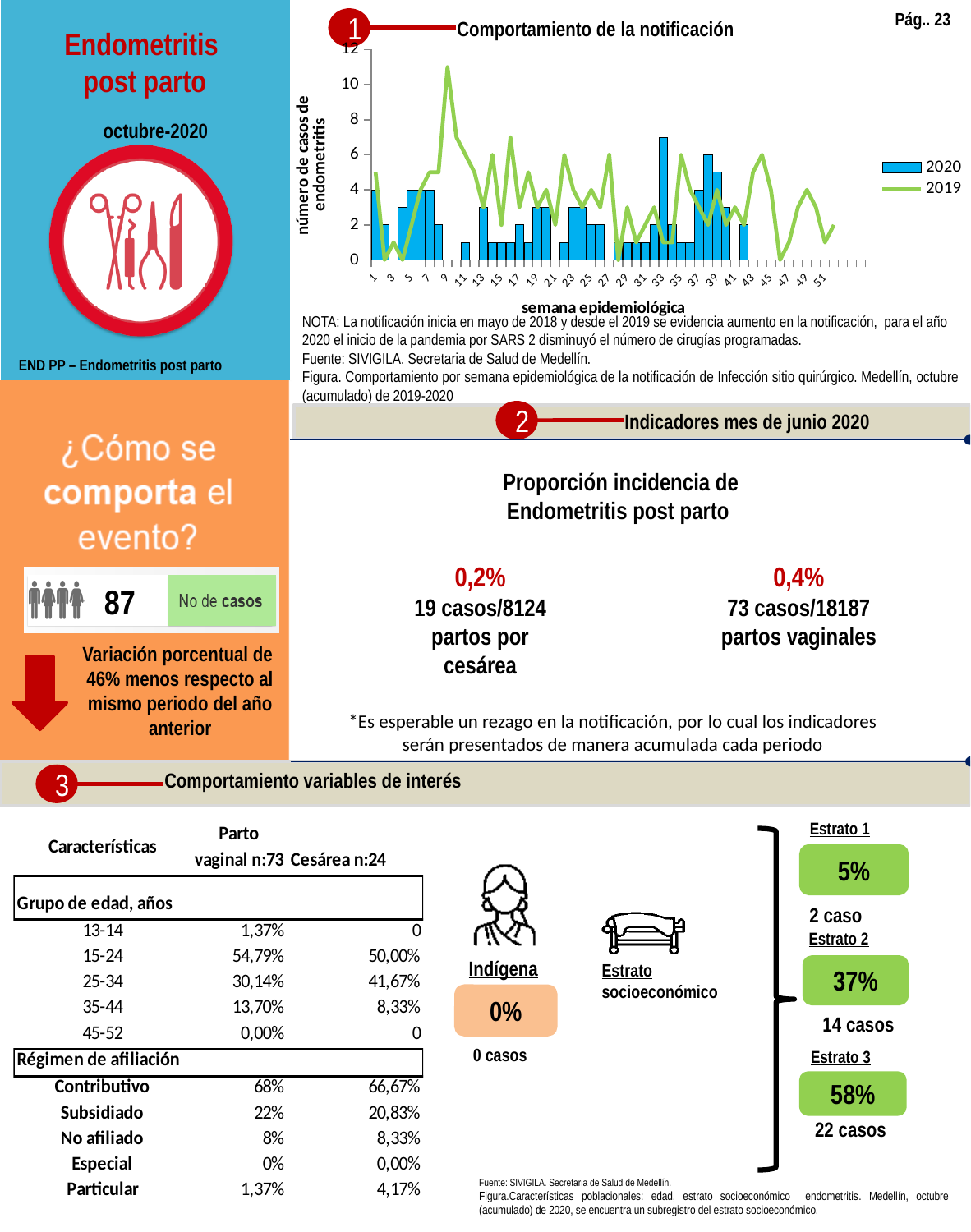
In the "Comportamiento de la notificación" chart, is the 2020 value at week 11 greater or less than 2? less In the "Comportamiento de la notificación" chart, is the 2019 value at week 9 greater or less than 8? greater In the "Comportamiento de la notificación" chart, is the 2020 value at week 1 greater or less than 2? greater In the "Comportamiento de la notificación" chart, which series has the higher value at week 33, 2019 or 2020? 2020 In the "Comportamiento de la notificación" chart, which series has the higher value at week 9, 2019 or 2020? 2019 How many series does the legend of the "Comportamiento de la notificación" chart list? 2 In the "Comportamiento de la notificación" chart, which year is plotted as bars? 2020 What kind of chart is shown under "Comportamiento de la notificación"? A combined bar and line chart What is the label of the x axis of the "Comportamiento de la notificación" chart? semana epidemiológica